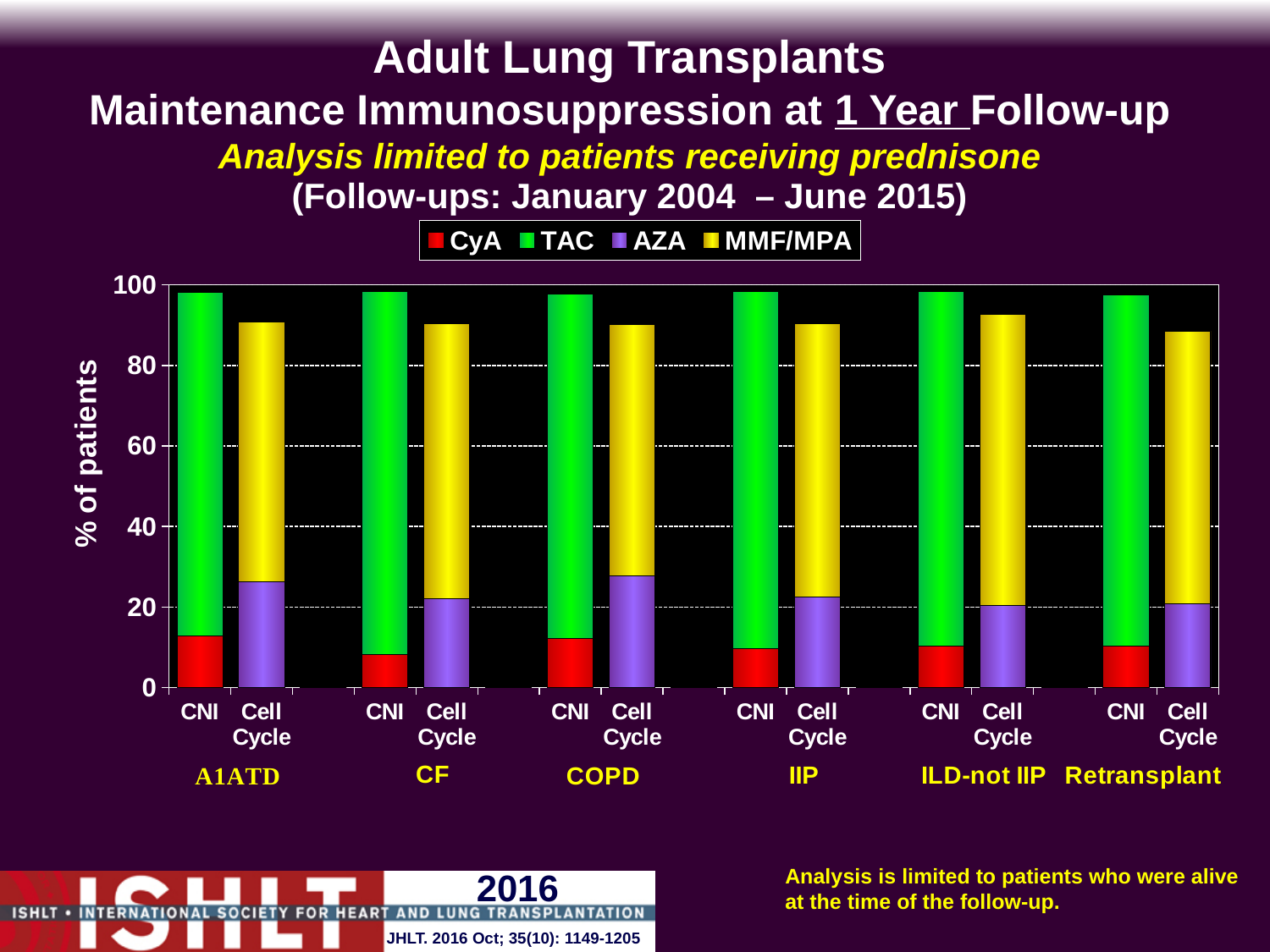
Which is larger, the AZA segment for COPD Cell Cycle or the AZA segment for ILD-not IIP Cell Cycle? COPD Cell Cycle How many series does the legend list? 4 How many diagnosis groups are shown along the x axis? 6 Which series are listed in the legend? CyA, TAC, AZA, MMF/MPA Is the total height of the Retransplant Cell Cycle bar greater or less than 80? greater For A1ATD, which bar is taller overall, CNI or Cell Cycle? CNI What is the label of the y axis? % of patients Is the total height of the CF CNI bar greater or less than 80? greater How many bars are plotted in total on the chart? 12 What kind of chart is shown on the slide? Stacked bar chart Is the CyA value for the A1ATD CNI bar greater or less than 20? less